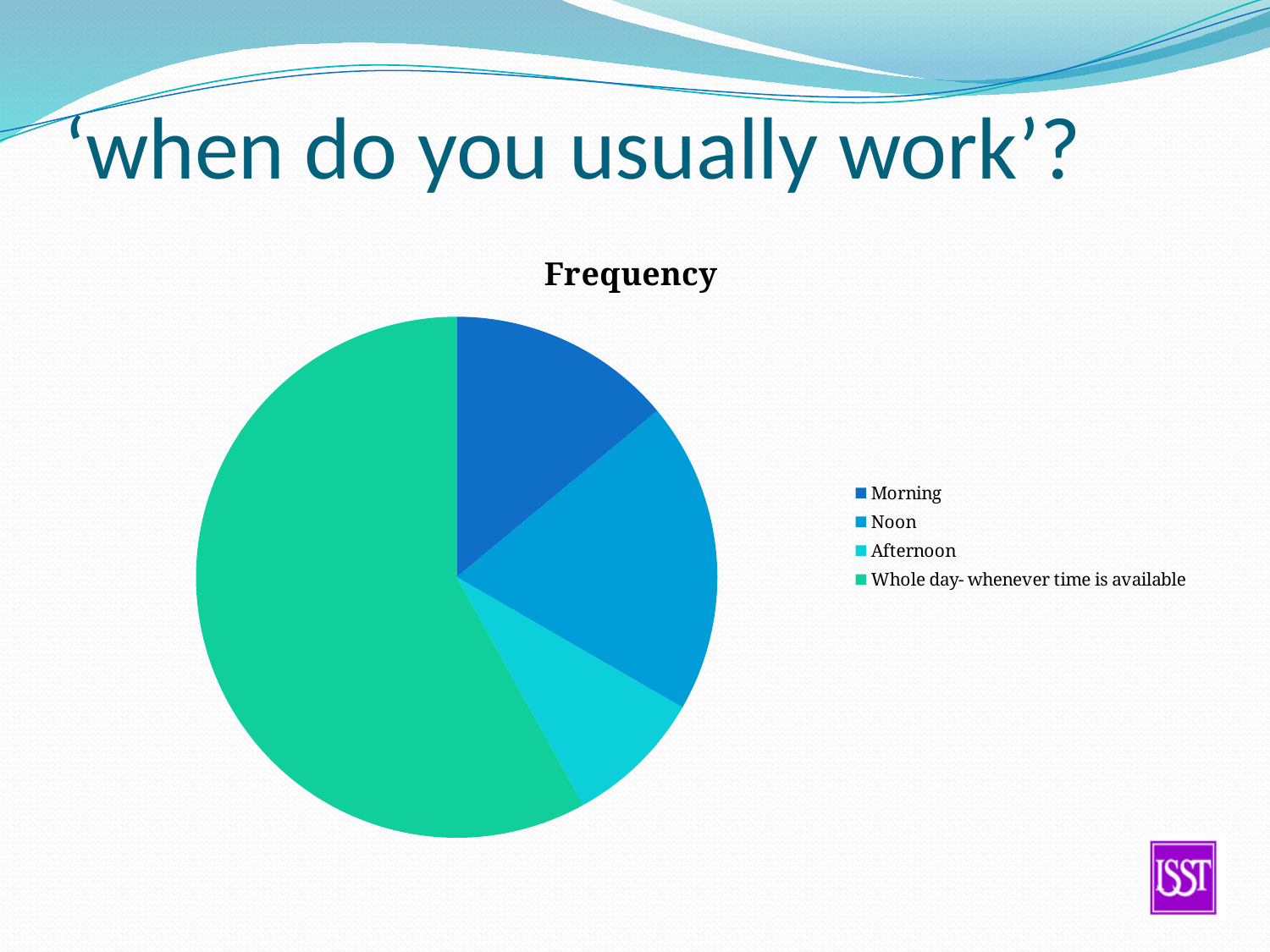
Which category is shown in the darkest blue colour in the pie chart? Morning Which slice is larger, Noon or Whole day- whenever time is available? Whole day- whenever time is available What is the title of the pie chart? Frequency Which slice is larger, Noon or Morning? Noon Which category has the largest slice of the pie chart? Whole day- whenever time is available Which category has the smallest slice of the pie chart? Afternoon How many slices does the pie chart have? 4 How many entries does the legend of the pie chart list? 4 What kind of chart is shown on the slide? pie chart Does the 'Whole day- whenever time is available' slice take up more or less than half of the pie? more